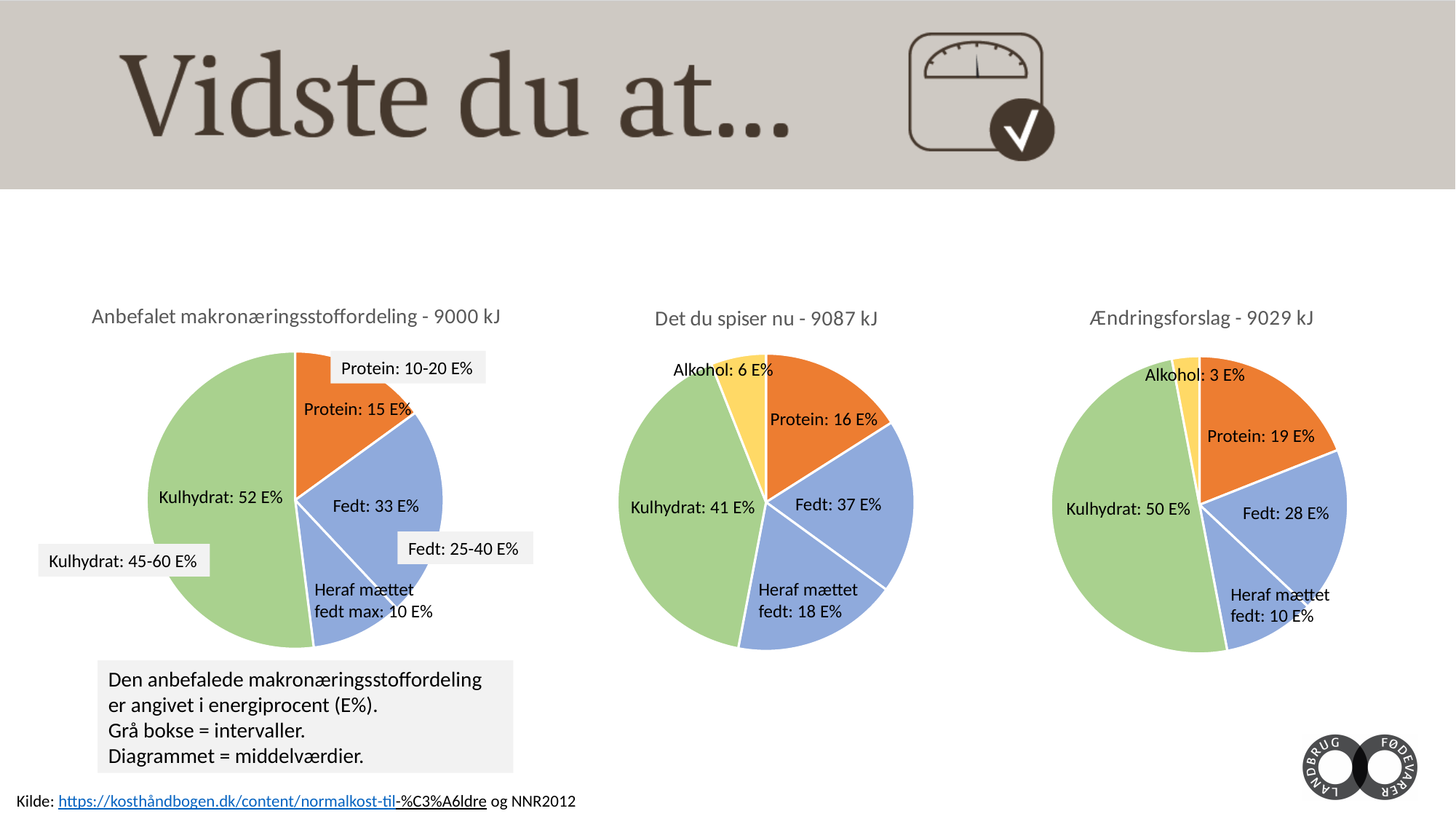
In the chart titled 'Det du spiser nu - 9087 kJ', what is the value for Kulhydrat? 41 E% Which is larger: Protein in 'Det du spiser nu - 9087 kJ' or Protein in 'Ændringsforslag - 9029 kJ'? Ændringsforslag - 9029 kJ In the chart titled 'Anbefalet makronæringsstoffordeling - 9000 kJ', what is the difference between Kulhydrat and Fedt? 19 E% In the chart titled 'Anbefalet makronæringsstoffordeling - 9000 kJ', what interval is given in the grey box for Kulhydrat? 45-60 E% What type of chart is used for 'Det du spiser nu - 9087 kJ'? Pie chart How many pie charts are shown on the slide? 3 In the chart titled 'Det du spiser nu - 9087 kJ', which category has the smallest share? Alkohol In the chart titled 'Ændringsforslag - 9029 kJ', what is the value for Fedt? 28 E% In the chart titled 'Ændringsforslag - 9029 kJ', which category has the largest share? Kulhydrat In the chart titled 'Anbefalet makronæringsstoffordeling - 9000 kJ', what is the value for Protein? 15 E% What is the difference between the Fedt value in 'Det du spiser nu - 9087 kJ' and the Fedt value in 'Ændringsforslag - 9029 kJ'? 9 E% In the chart titled 'Det du spiser nu - 9087 kJ', what is the value for Alkohol? 6 E%